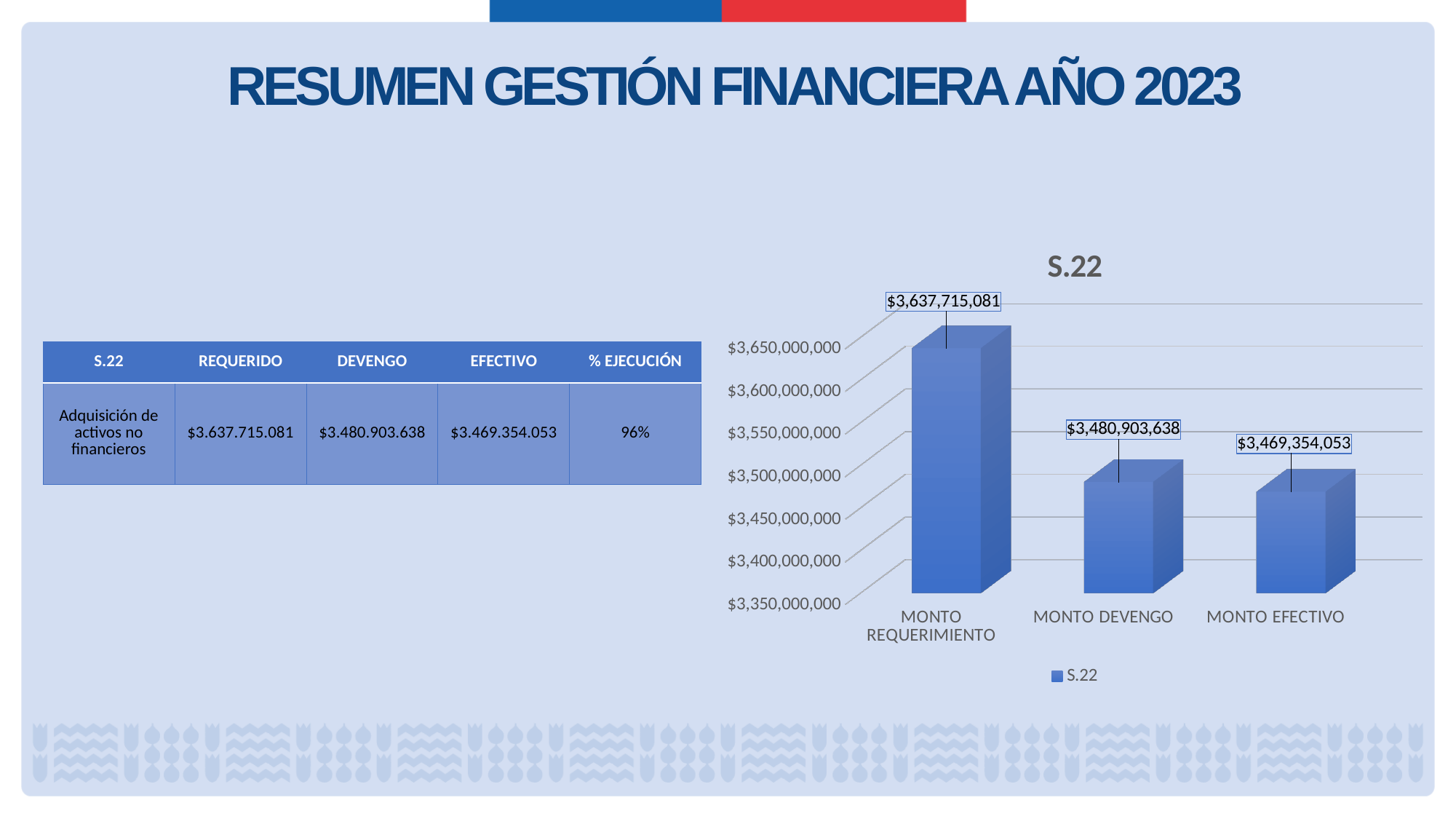
What is the value for MONTO REQUERIMIENTO in the S.22 chart? $3,637,715,081 How many categories are shown in the S.22 chart? 3 Which is larger in the S.22 chart, MONTO DEVENGO or MONTO EFECTIVO? MONTO DEVENGO Do the values rise or fall from left to right across the categories in the S.22 chart? fall Is the value for MONTO REQUERIMIENTO greater or less than $3,600,000,000? greater What kind of chart is the S.22 chart? bar chart What is the difference between MONTO DEVENGO and MONTO EFECTIVO in the S.22 chart? $11,549,585 Which category has the highest value in the S.22 chart? MONTO REQUERIMIENTO What is the value for MONTO EFECTIVO in the S.22 chart? $3,469,354,053 What is the difference between MONTO REQUERIMIENTO and MONTO DEVENGO in the S.22 chart? $156,811,443 What is the value for MONTO DEVENGO in the S.22 chart? $3,480,903,638 Which category has the lowest value in the S.22 chart? MONTO EFECTIVO